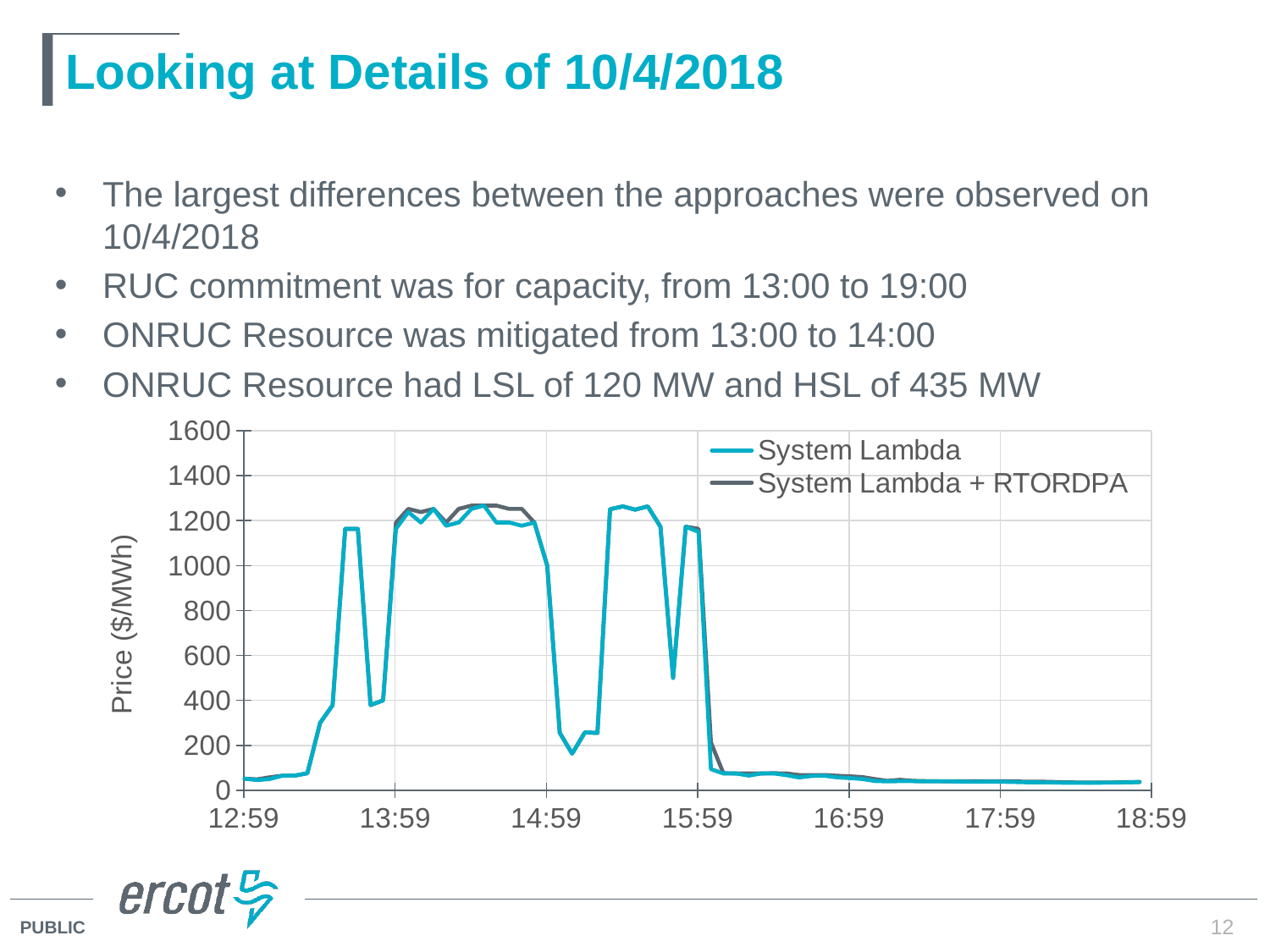
Is the System Lambda value at 16:59 greater or less than 200? less What kind of chart is shown on the slide? line chart What is the label on the chart's vertical axis? Price ($/MWh) Is the System Lambda value at 12:59 greater or less than 200? less Between 15:59 and 16:59, does the System Lambda line overall rise or fall? fall Is the System Lambda value at 17:59 greater or less than 400? less Between 12:59 and 13:59, does the System Lambda line overall rise or fall? rise How many series does the chart legend list? 2 How many time labels are shown along the chart's x axis? 7 What are the two series named in the chart legend? System Lambda; System Lambda + RTORDPA